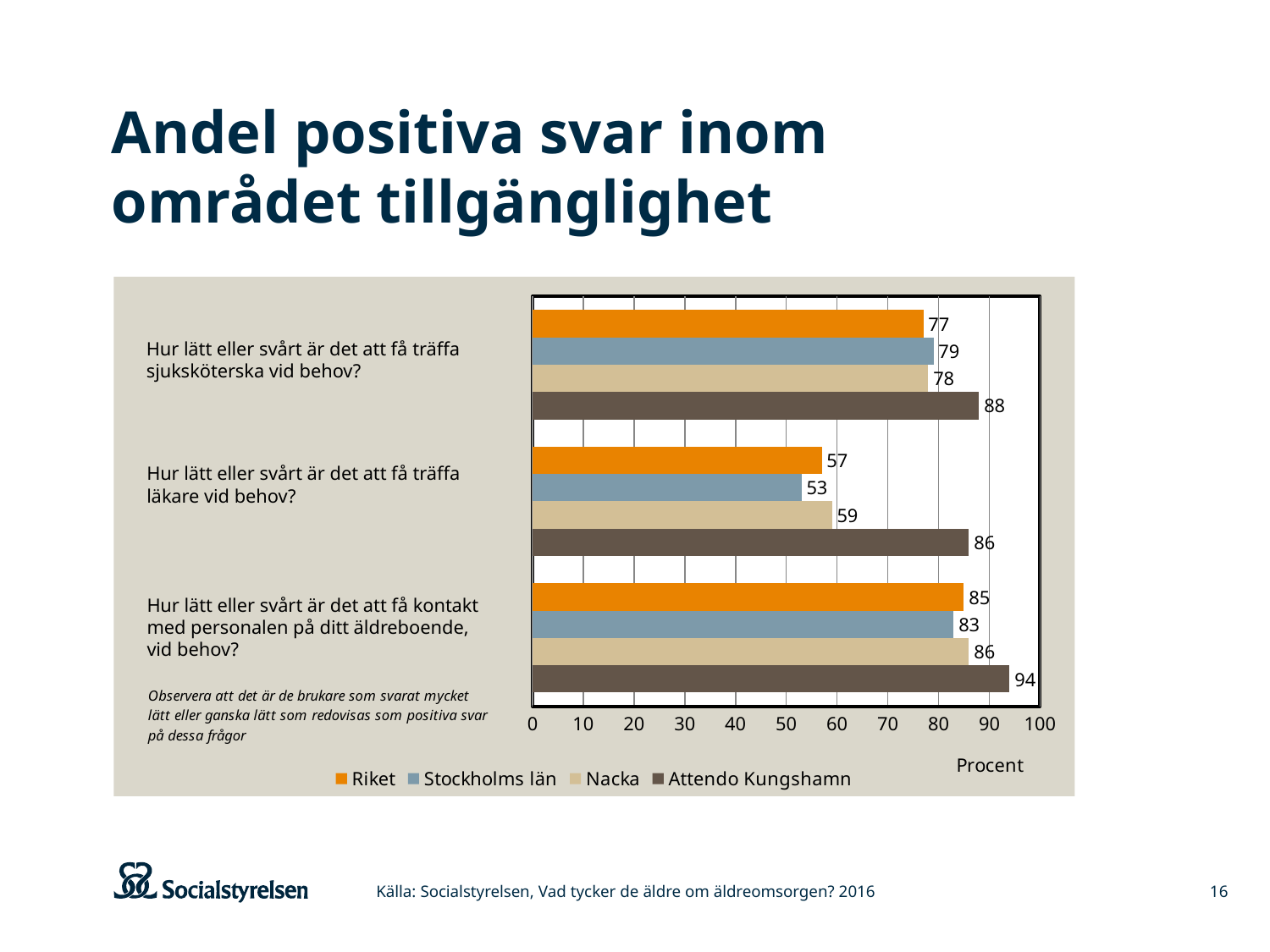
Which series has the lowest value for 'Hur lätt eller svårt är det att få kontakt med personalen på ditt äldreboende, vid behov?' Stockholms län Which is larger for 'Hur lätt eller svårt är det att få träffa sjuksköterska vid behov?': Riket or Stockholms län? Stockholms län What is the label of the x axis? Procent What is the highest value shown on the chart? 94 How many question categories are shown on the chart? 3 What is the value for Riket for 'Hur lätt eller svårt är det att få kontakt med personalen på ditt äldreboende, vid behov?' 85 What type of chart is shown on the slide? bar chart What is the value for Stockholms län for 'Hur lätt eller svårt är det att få träffa läkare vid behov?' 53 How many series does the legend list? 4 What is the value for Attendo Kungshamn for 'Hur lätt eller svårt är det att få träffa sjuksköterska vid behov?' 88 Which series has the highest value for 'Hur lätt eller svårt är det att få träffa läkare vid behov?' Attendo Kungshamn What is the difference between Attendo Kungshamn and Nacka for 'Hur lätt eller svårt är det att få träffa läkare vid behov?' 27